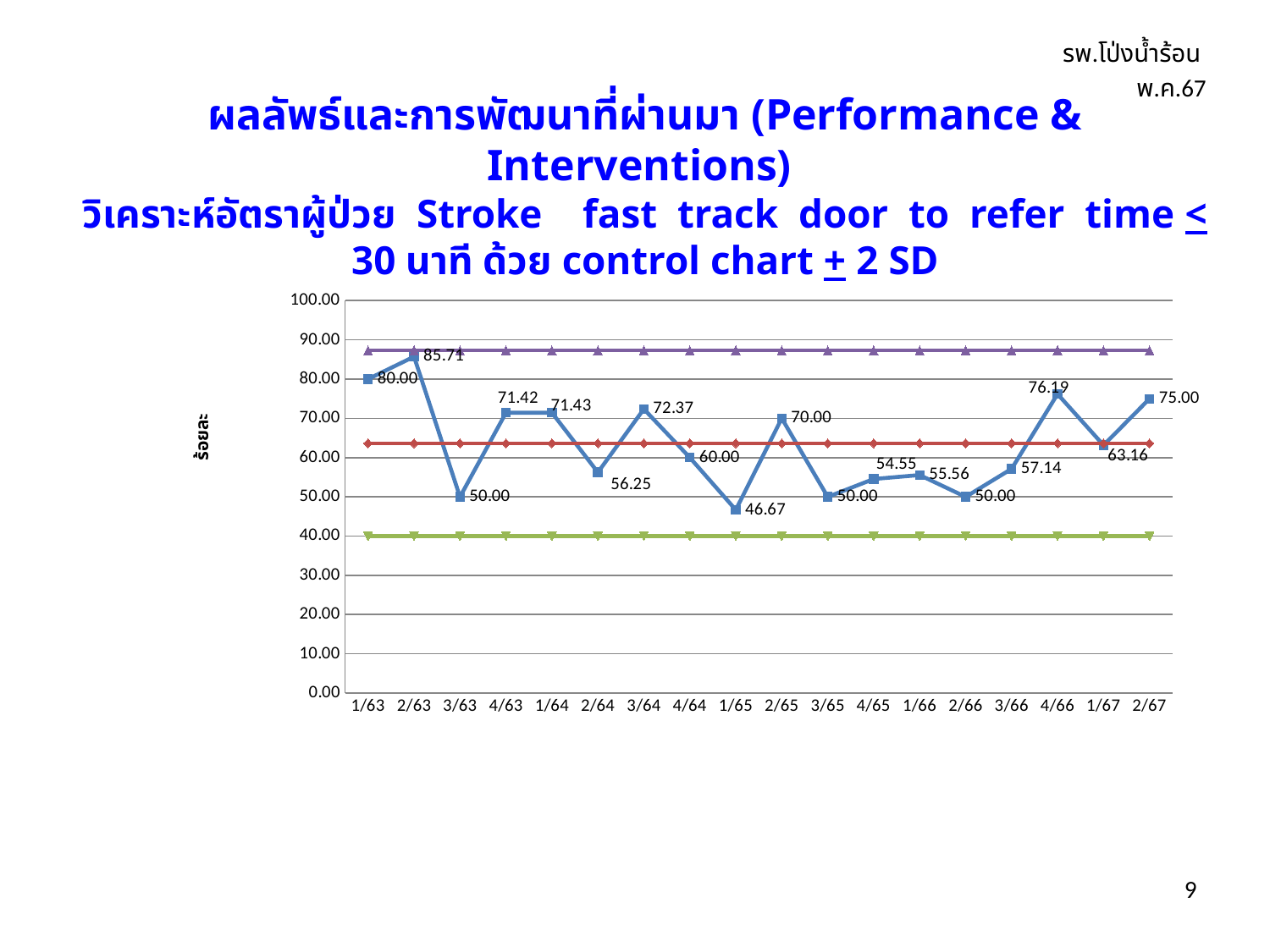
Which period has the highest plotted value on the data line? 2/63 How many periods are shown on the x axis? 18 What is the value plotted for 4/66? 76.19 Which is larger, the value for 3/64 or the value for 4/64? 3/64 Is the value of the lower flat control line greater or less than 50.00? less Does the data line rise or fall from 1/66 to 4/66? rise What is the difference between the values for 1/63 and 3/63? 30.00 What kind of chart is shown on the slide? line chart What is the value plotted for 2/67? 75.00 Which period has the lowest plotted value on the data line? 1/65 What is the value plotted for 2/63? 85.71 What is the value plotted for 1/65? 46.67